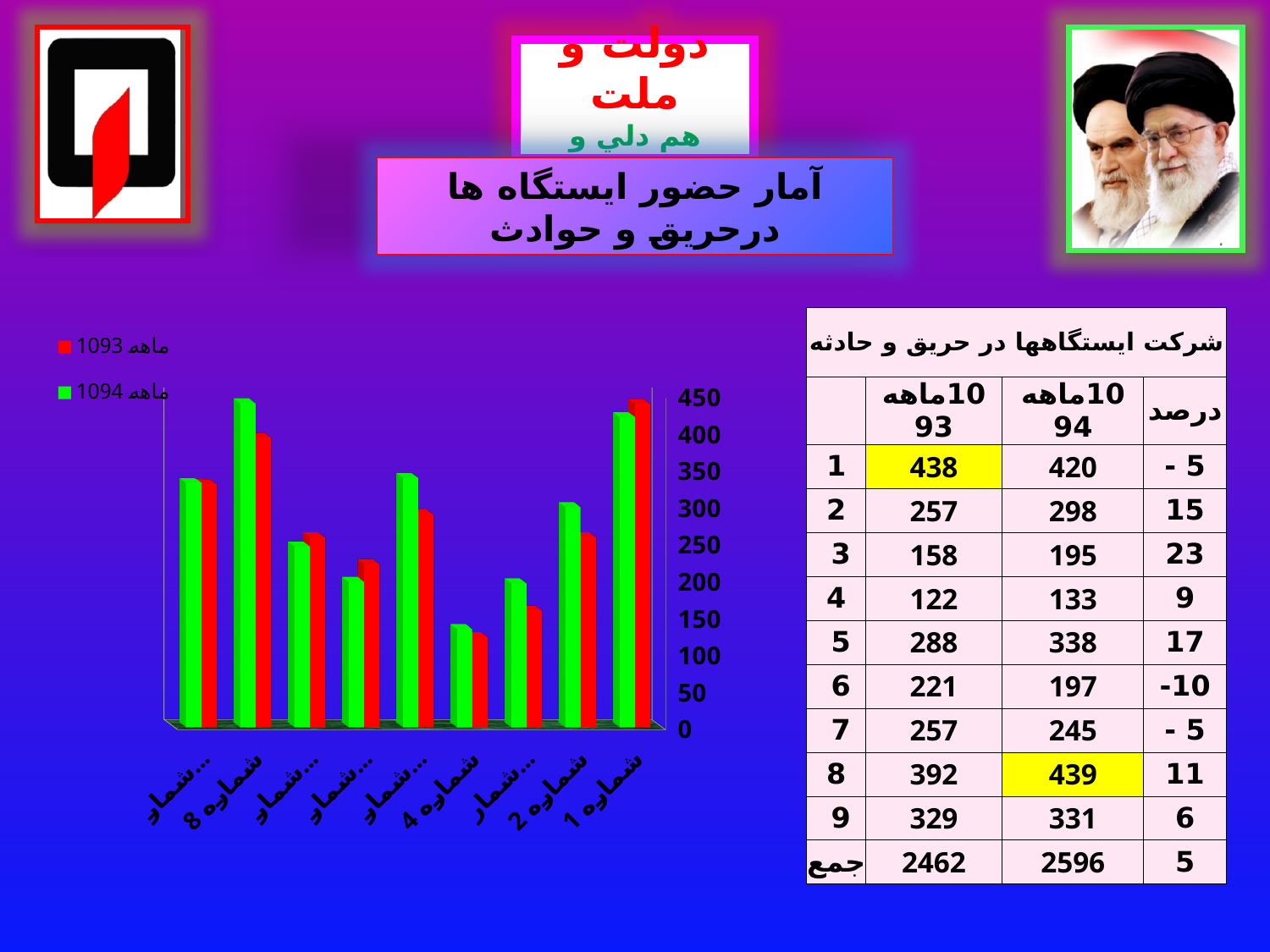
Is the red bar for شماره 4 greater or less than 150? less Is the green bar for شماره 1 greater or less than 400? greater For شماره 2, which bar is taller, the red one or the green one? green According to the table on the slide, what is the difference between station 1's 10ماهه 93 value (438) and its 10ماهه 94 value (420)? 18 What kind of chart is shown on the slide? bar chart Which station has the highest red (ماهه 1093) bar? شماره 1 Which station has the lowest green (ماهه 1094) bar? شماره 4 Which series is drawn in green according to the legend? ماهه 1094 How many series does the chart legend list? 2 What is the highest value shown on the chart's vertical axis? 450 How many categories (stations) are plotted on the chart? 9 According to the table on the slide, what is the value for station 1 in the 10ماهه 93 column? 438